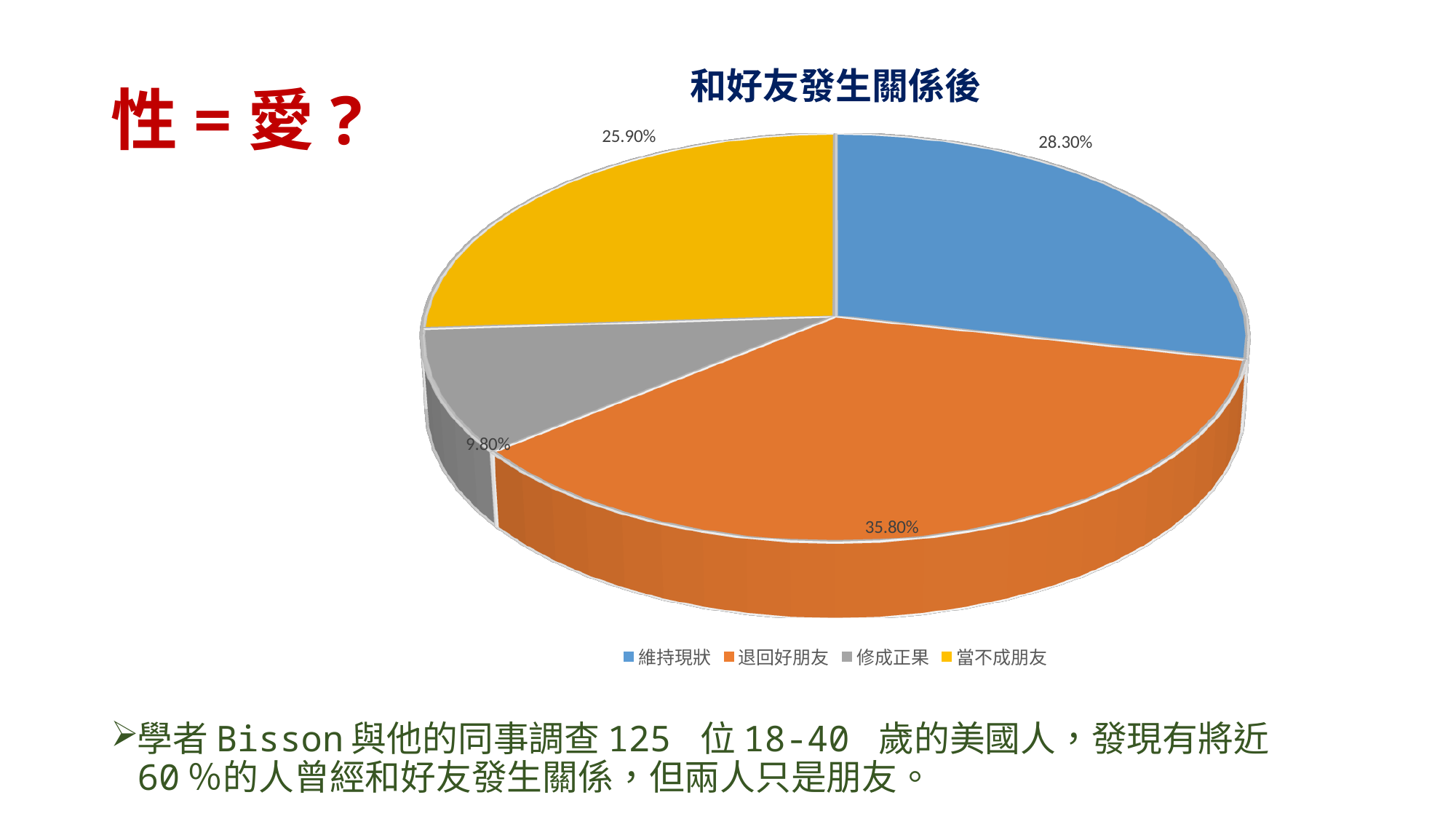
How many categories does the pie chart show? 4 Which is larger, the share for 維持現狀 or the share for 當不成朋友? 維持現狀 Which colour represents 當不成朋友 in the legend? Yellow What is the difference in percentage points between 退回好朋友 and 修成正果? 26 percentage points What percentage of the pie is labelled for 退回好朋友? 35.80% What is the title of the chart? 和好友發生關係後 What percentage of the pie is labelled for 維持現狀? 28.30% What type of chart is shown on the slide? Pie chart What percentage of the pie is labelled for 當不成朋友? 25.90% Which category has the smallest share of the pie? 修成正果 Which category has the largest share of the pie? 退回好朋友 What percentage of the pie is labelled for 修成正果? 9.80%